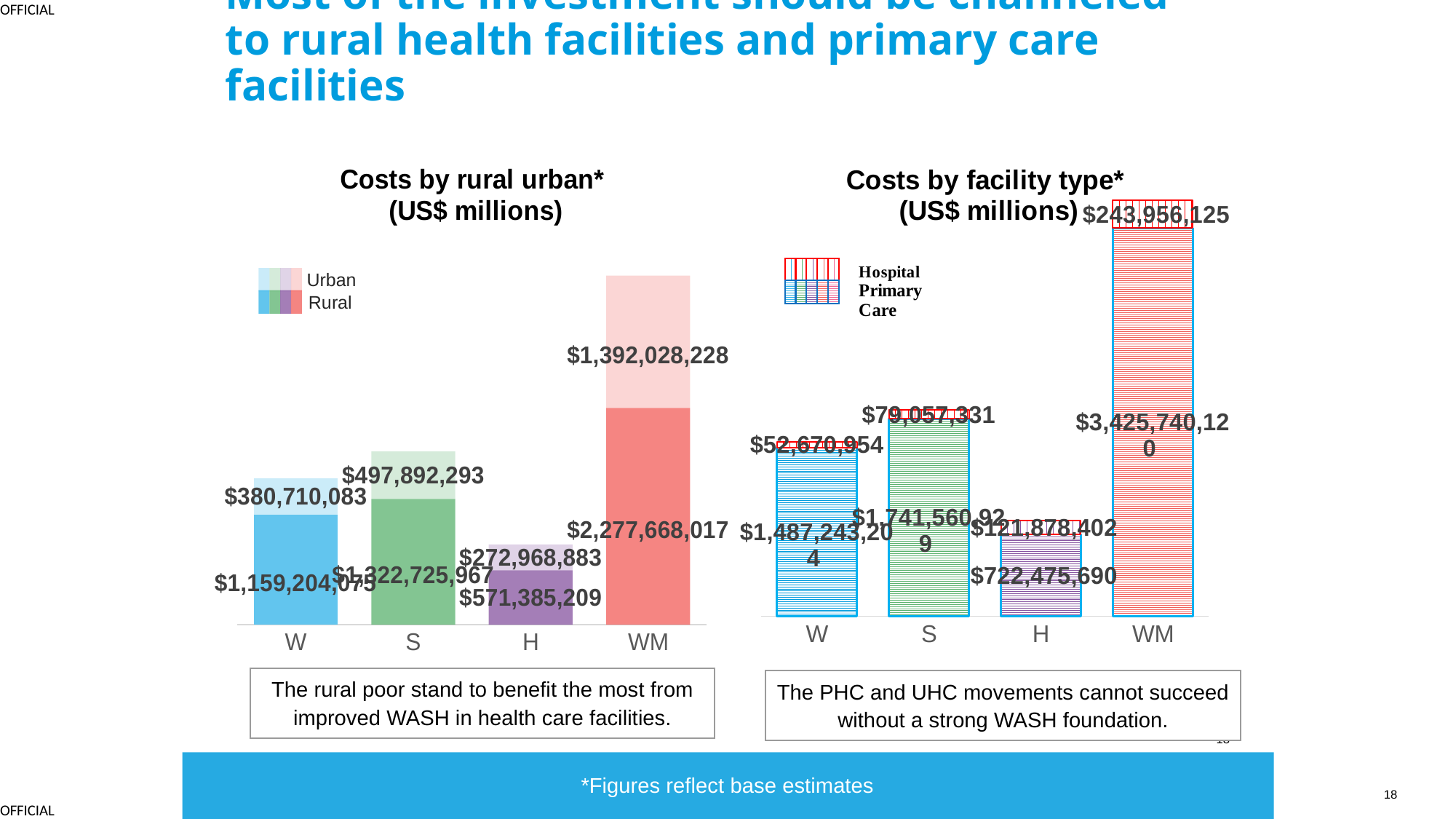
In the 'Costs by facility type*' chart, what is the Primary Care value for WM? $3,425,740,120 In the 'Costs by facility type*' chart, what is the total of the stacked bar for H? $844,354,092 In the 'Costs by rural urban*' chart, what is the Urban value for WM? $1,392,028,228 How many series does the legend of the 'Costs by rural urban*' chart list? 2 In the 'Costs by rural urban*' chart, what is the difference between the Urban value for WM and the Urban value for H? $1,119,059,345 What are the two legend entries in the 'Costs by facility type*' chart? Hospital, Primary Care In the 'Costs by rural urban*' chart, which category has the shortest stacked bar? H In the 'Costs by rural urban*' chart, which category has the tallest stacked bar? WM In the 'Costs by rural urban*' chart, what is the Urban value for S? $497,892,293 In the 'Costs by rural urban*' chart, what is the Rural value for H? $571,385,209 What kind of chart is the 'Costs by rural urban*' chart on the left? bar chart In the 'Costs by facility type*' chart, what is the Hospital value for H? $121,878,402